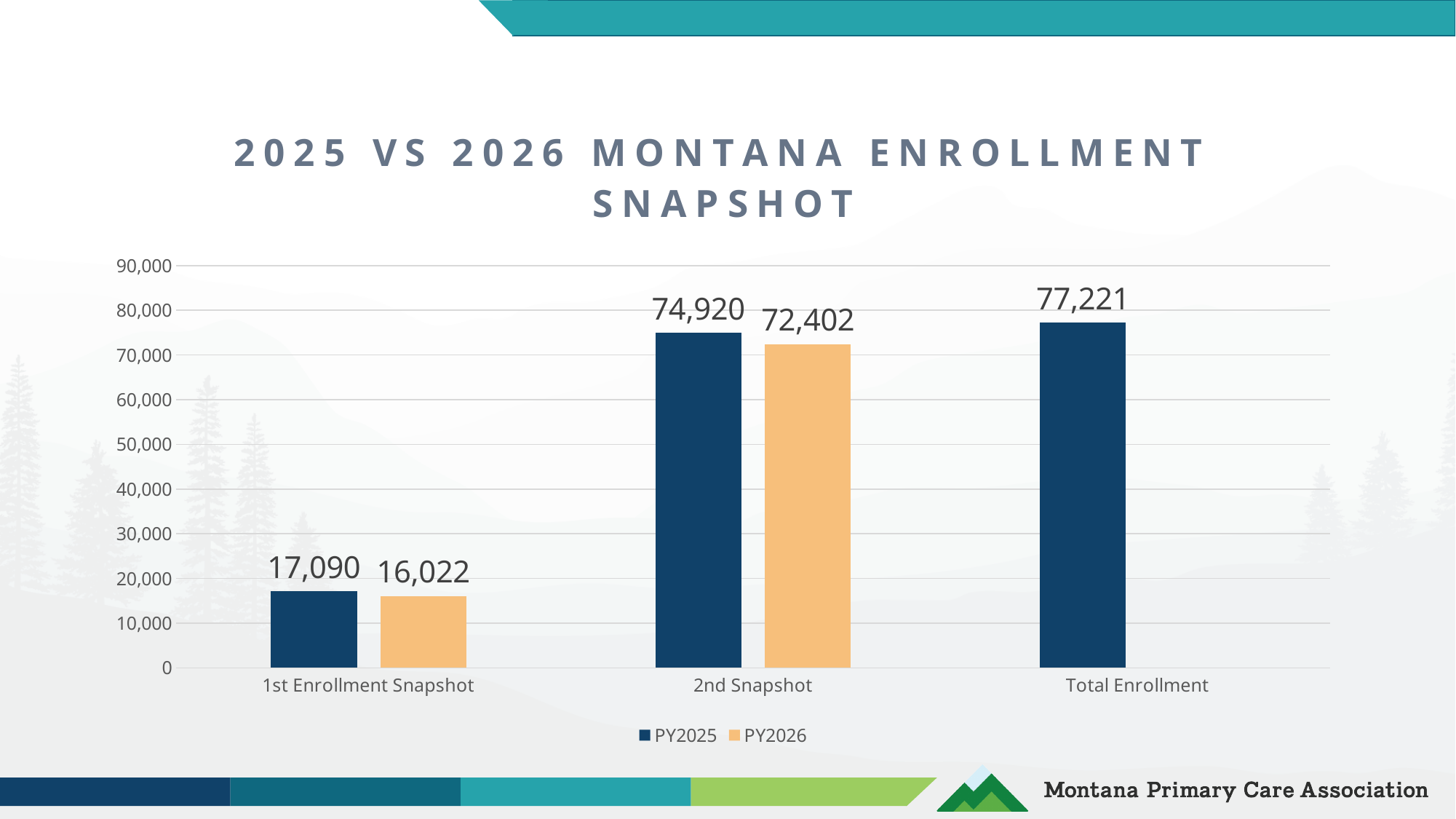
What is the title of the chart? 2025 vs 2026 Montana Enrollment Snapshot What is the PY2026 value for the 2nd Snapshot? 72,402 What is the difference between the PY2025 and PY2026 values for the 2nd Snapshot? 2,518 Which category has the highest PY2025 value? Total Enrollment What kind of chart is shown on the slide? Bar chart What is the PY2026 value for the 1st Enrollment Snapshot? 16,022 Which is larger for the 1st Enrollment Snapshot, PY2025 or PY2026? PY2025 What is the PY2025 value for Total Enrollment? 77,221 Which category has the lowest PY2026 value? 1st Enrollment Snapshot How many categories are shown on the x axis? 3 How many series does the legend list? 2 What is the PY2025 value for the 1st Enrollment Snapshot? 17,090